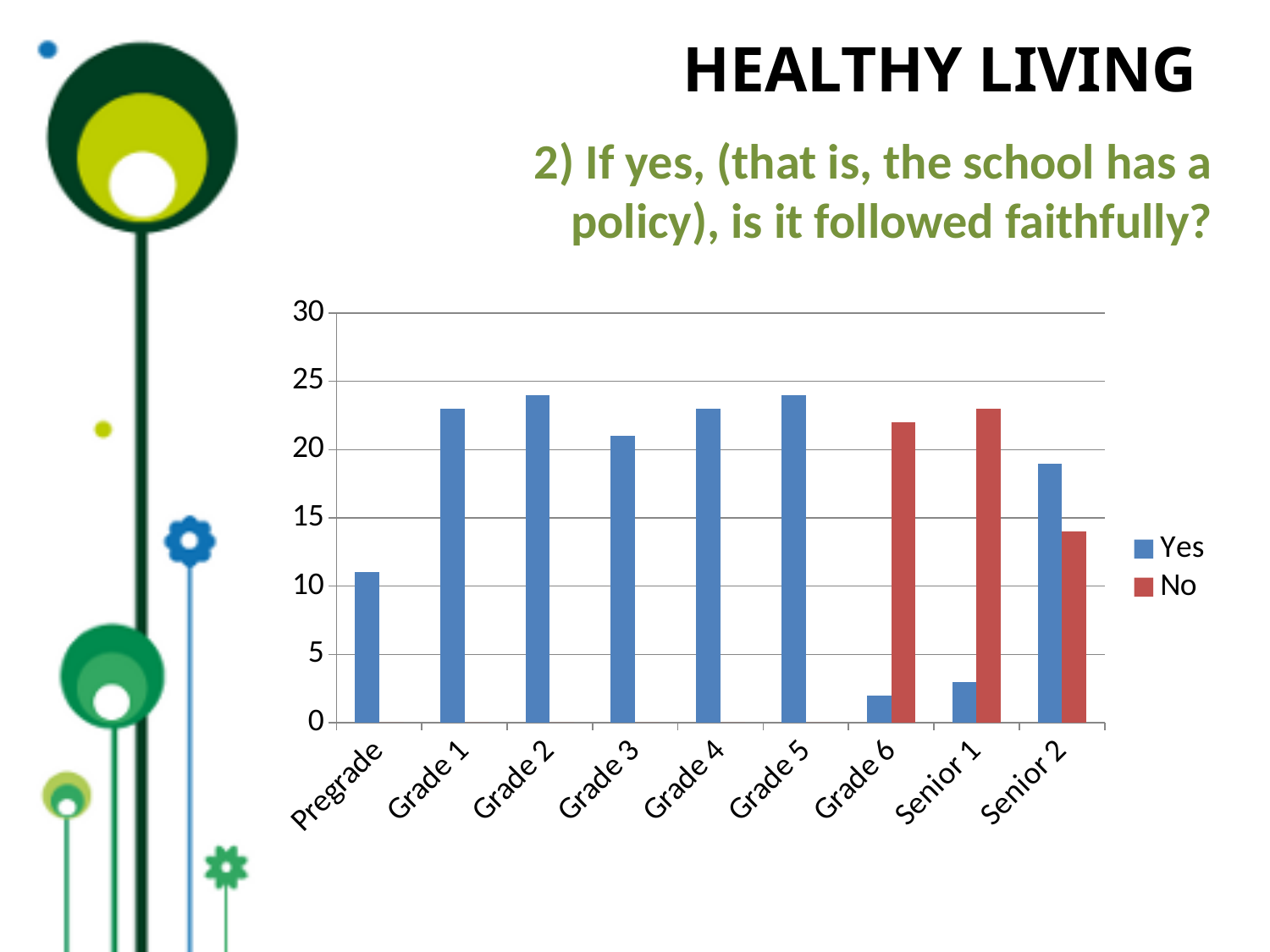
Which category has the lowest No value among those with a No bar? Senior 2 How many series does the chart legend list? 2 For Senior 2, which is larger, the Yes value or the No value? Yes Is the Yes value for Pregrade greater or less than 15? less For Grade 6, which is larger, the Yes value or the No value? No Is the No value for Senior 1 greater or less than 20? greater Is the Yes value for Grade 6 greater or less than 5? less What kind of chart is shown on the slide? bar chart How many grade categories are shown along the x axis? 9 What colour are the No bars in the chart? red